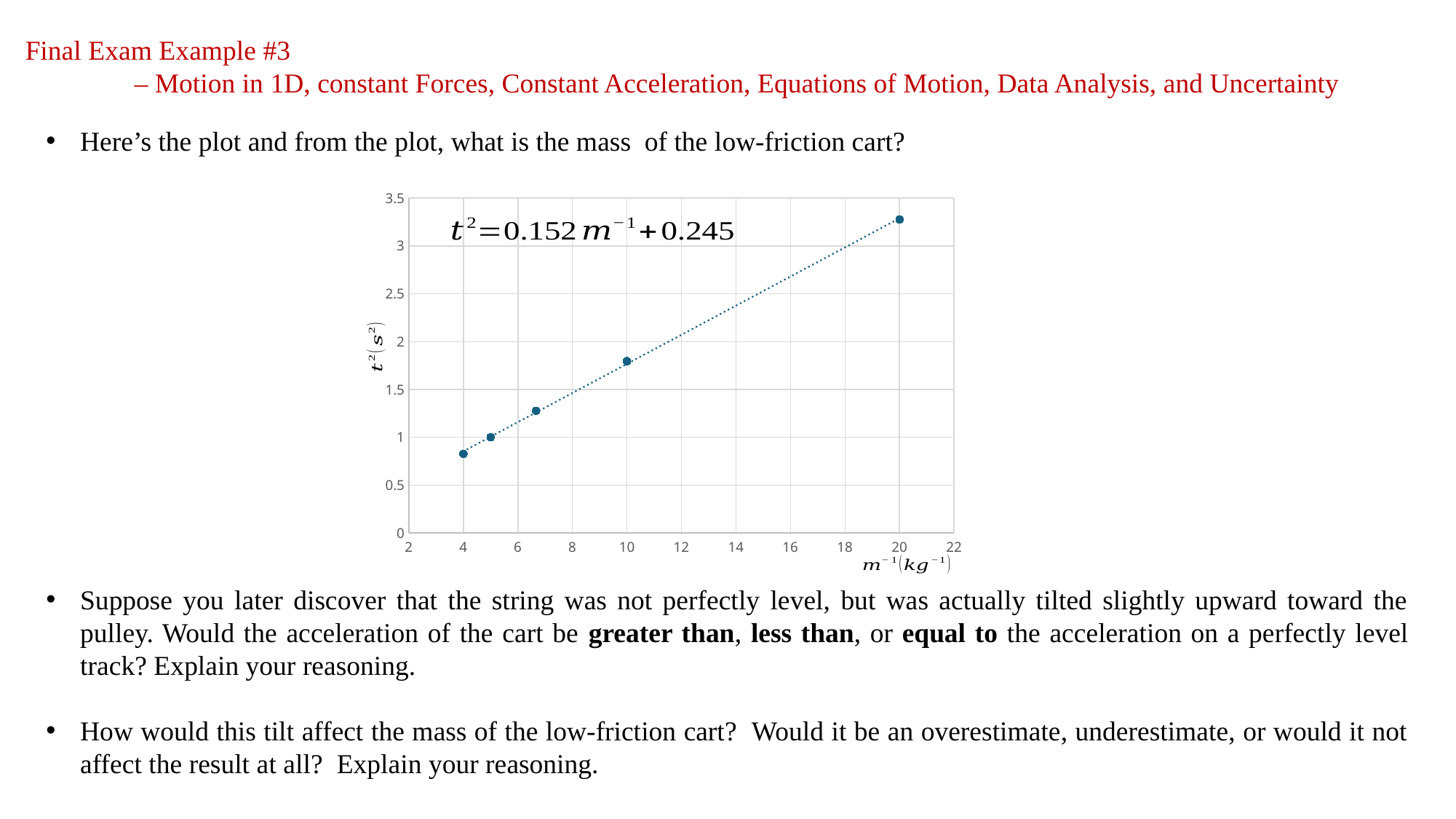
Is the t² value for the point at m⁻¹ = 10 greater or less than 1.5? greater At which x value (m⁻¹) is the lowest plotted t² value? 4 Which point has the larger t² value: the one at m⁻¹ = 10 or the one at m⁻¹ = 4? The one at m⁻¹ = 10 What is the label of the y axis of the chart? t²(s²) Is the t² value for the point at m⁻¹ = 20 greater or less than 3? greater Do the plotted t² values rise or fall as m⁻¹ increases along the x axis? Rise What is the slope of the fitted line according to the equation printed on the chart? 0.152 At which x value (m⁻¹) is the highest plotted t² value? 20 What kind of chart is shown on the slide? Scatter plot with a trend line Is the t² value for the point at m⁻¹ = 4 greater or less than 1? less How many data points are plotted on the chart? 5